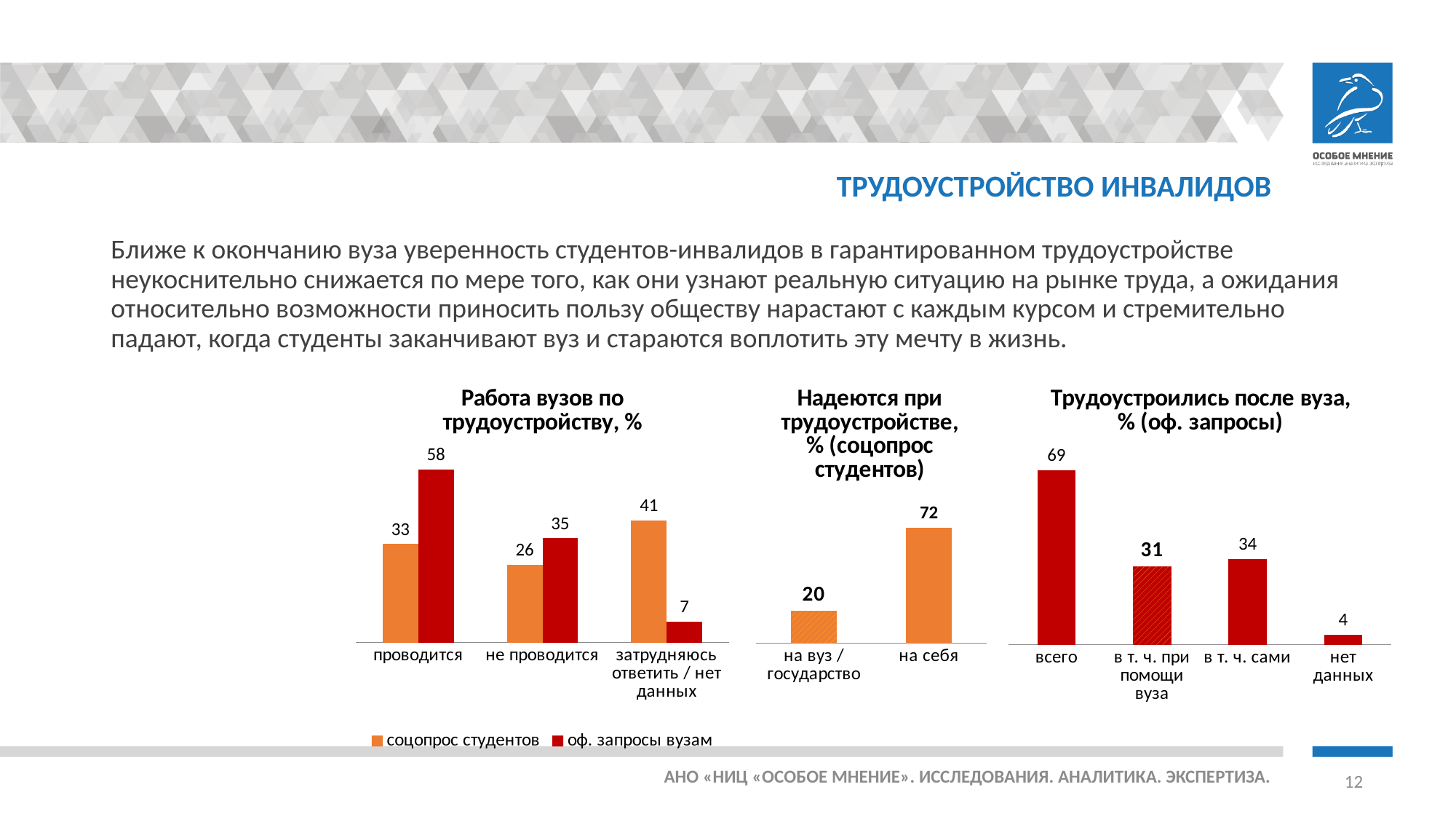
In the chart 'Трудоустроились после вуза, % (оф. запросы)', what is the value for 'в т. ч. при помощи вуза'? 31 How many categories are shown in the chart 'Трудоустроились после вуза, % (оф. запросы)'? 4 In the chart 'Трудоустроились после вуза, % (оф. запросы)', which category has the lowest value? нет данных In the chart 'Работа вузов по трудоустройству, %', which series has the larger value for 'не проводится'? оф. запросы вузам What kind of chart is 'Надеются при трудоустройстве, % (соцопрос студентов)'? bar chart In the chart 'Работа вузов по трудоустройству, %', what is the value for 'затрудняюсь ответить / нет данных' in the 'соцопрос студентов' series? 41 In the chart 'Работа вузов по трудоустройству, %', what is the difference between the two series for 'проводится'? 25 In the chart 'Работа вузов по трудоустройству, %', what is the value for 'проводится' in the 'оф. запросы вузам' series? 58 How many series does the legend of the chart 'Работа вузов по трудоустройству, %' list? 2 In the chart 'Надеются при трудоустройстве, % (соцопрос студентов)', what is the difference between 'на себя' and 'на вуз / государство'? 52 In the chart 'Трудоустроились после вуза, % (оф. запросы)', which category has the highest value? всего In the chart 'Надеются при трудоустройстве, % (соцопрос студентов)', what is the value for 'на себя'? 72